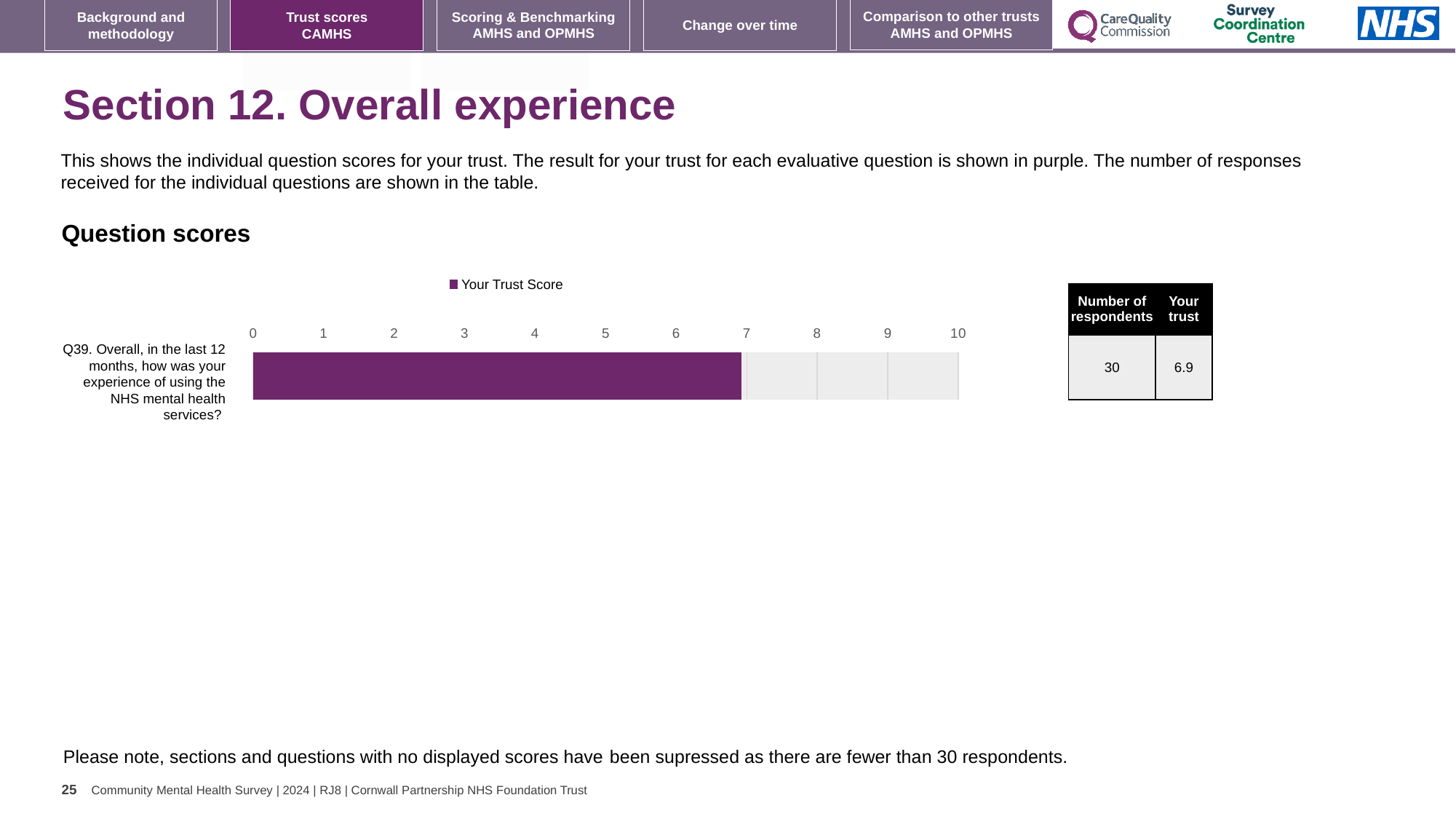
Is the trust score for Q39 greater or less than 5? greater How many questions (categories) are plotted in the chart? 1 What kind of chart is shown under 'Question scores'? bar chart How many series does the chart legend list? 1 How many respondents answered Q39 according to the table next to the chart? 30 What is the maximum value shown on the chart's axis? 10 What is the trust score for Q39 (Overall, in the last 12 months, how was your experience of using the NHS mental health services?)? 6.9 Is the trust score for Q39 greater or less than 8? less What is the name of the series shown in the chart legend? Your Trust Score